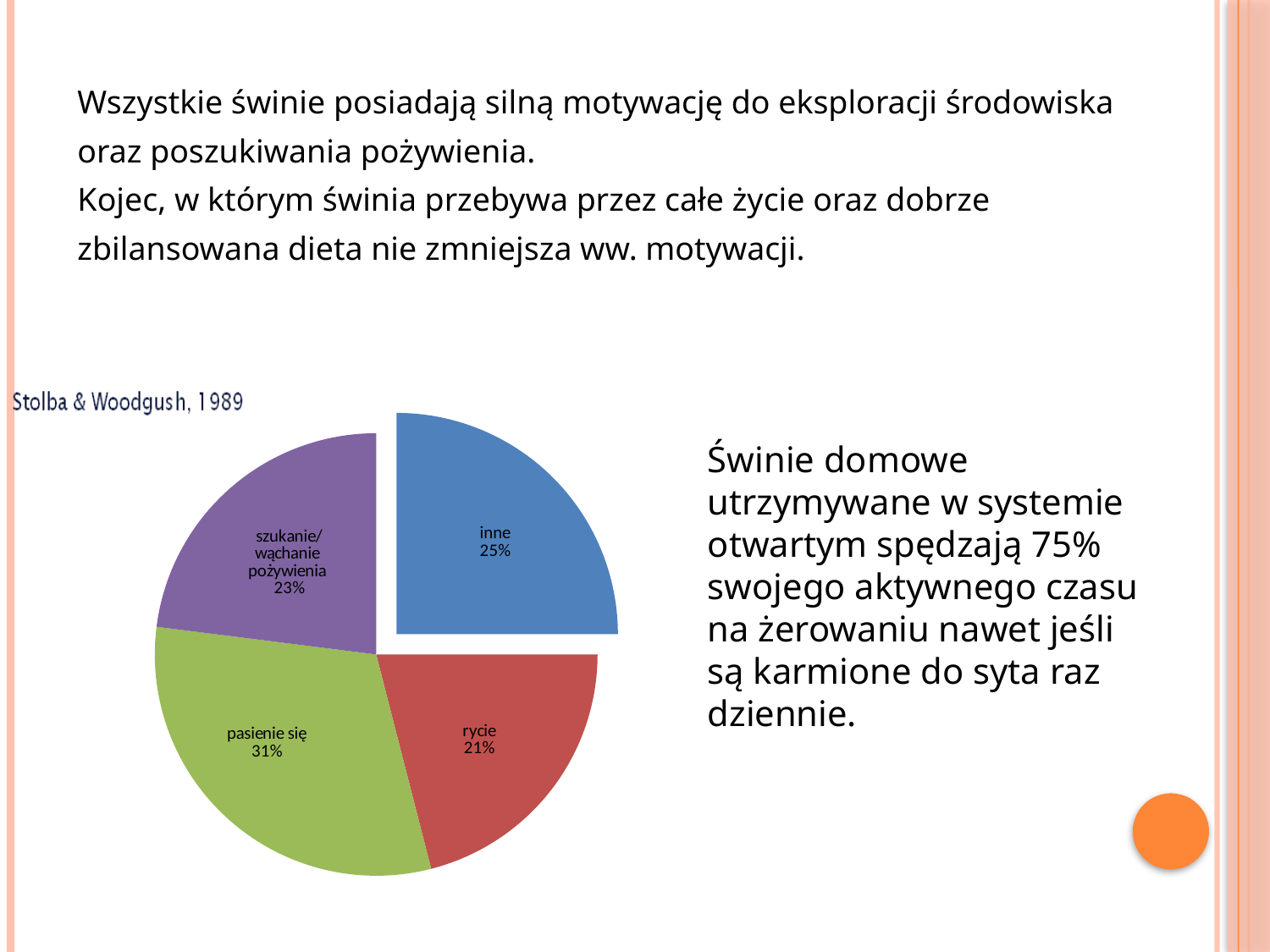
What share of the pie does "pasienie się" represent? 31% What share of the pie does "inne" represent? 25% Which slice of the pie chart is the smallest? rycie Which is larger, the share for "inne" or the share for "szukanie/wąchanie pożywienia"? inne What is the difference in percentage points between "pasienie się" and "rycie"? 10 What share of the pie does "szukanie/wąchanie pożywienia" represent? 23% What colour is the "inne" slice of the pie chart? blue What kind of chart is shown on the slide? pie chart Which slice of the pie chart is the largest? pasienie się What is the combined share of "pasienie się", "rycie" and "szukanie/wąchanie pożywienia"? 75% How many slices does the pie chart have? 4